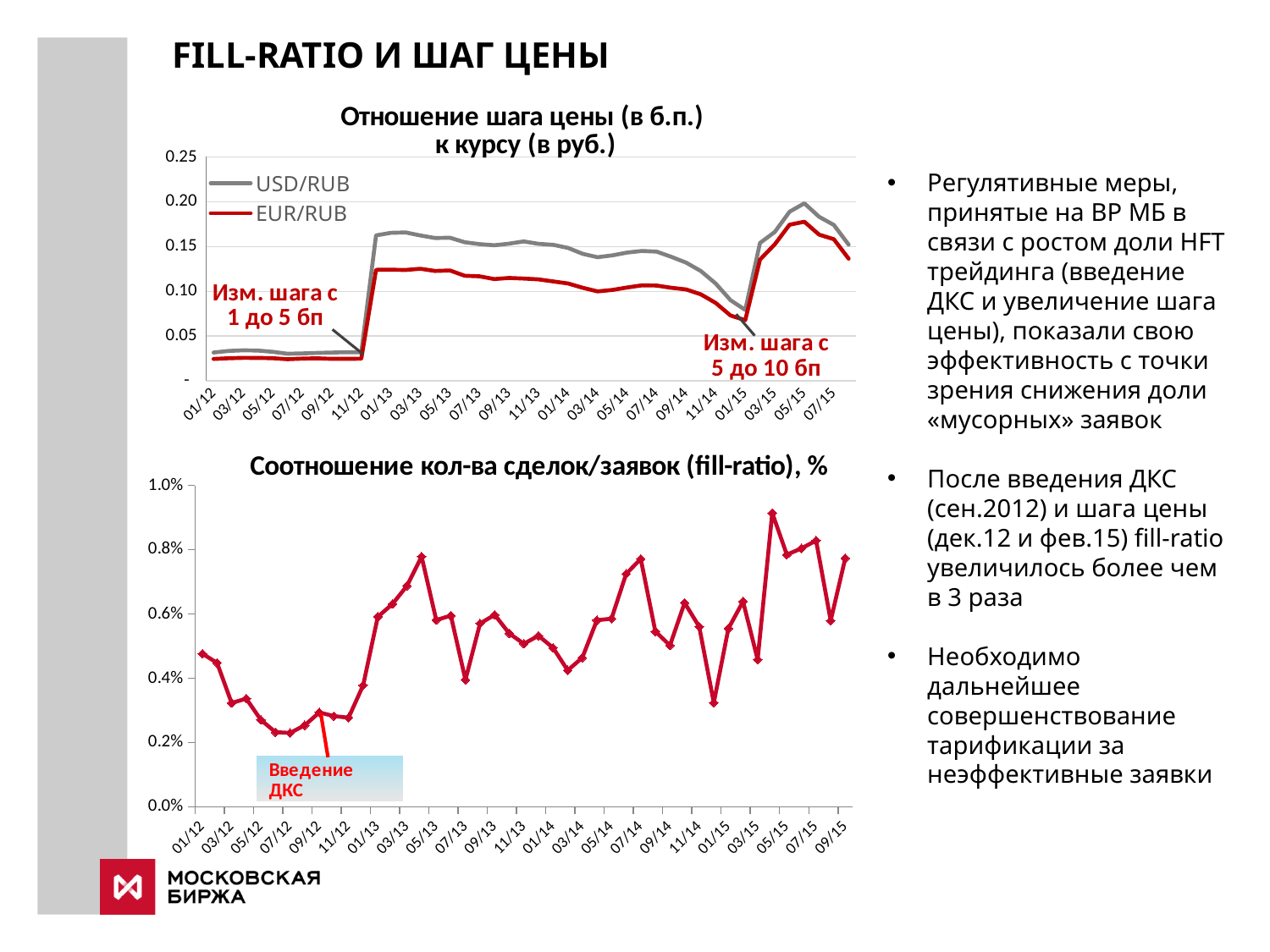
How many series does the legend of the top chart list? 2 In the top chart, is the EUR/RUB value at 01/12 greater or less than 0.05? less What kind of chart is the bottom chart titled 'Соотношение кол-ва сделок/заявок (fill-ratio), %'? Line chart In the top chart, does the USD/RUB line rise or fall between 01/13 and 11/14? fall In the bottom chart, is the fill-ratio value at 03/13 greater or less than 0.6%? greater In the top chart, which two series are listed in the legend? USD/RUB and EUR/RUB What kind of chart is the top chart titled 'Отношение шага цены (в б.п.) к курсу (в руб.)'? Line chart In the top chart, is the USD/RUB value at 05/15 greater or less than 0.15? greater In the top chart, which series is higher at 01/13: USD/RUB or EUR/RUB? USD/RUB In the bottom chart, does the fill-ratio rise or fall between 01/12 and 07/12? fall What event does the annotation box in the bottom chart mark? Введение ДКС